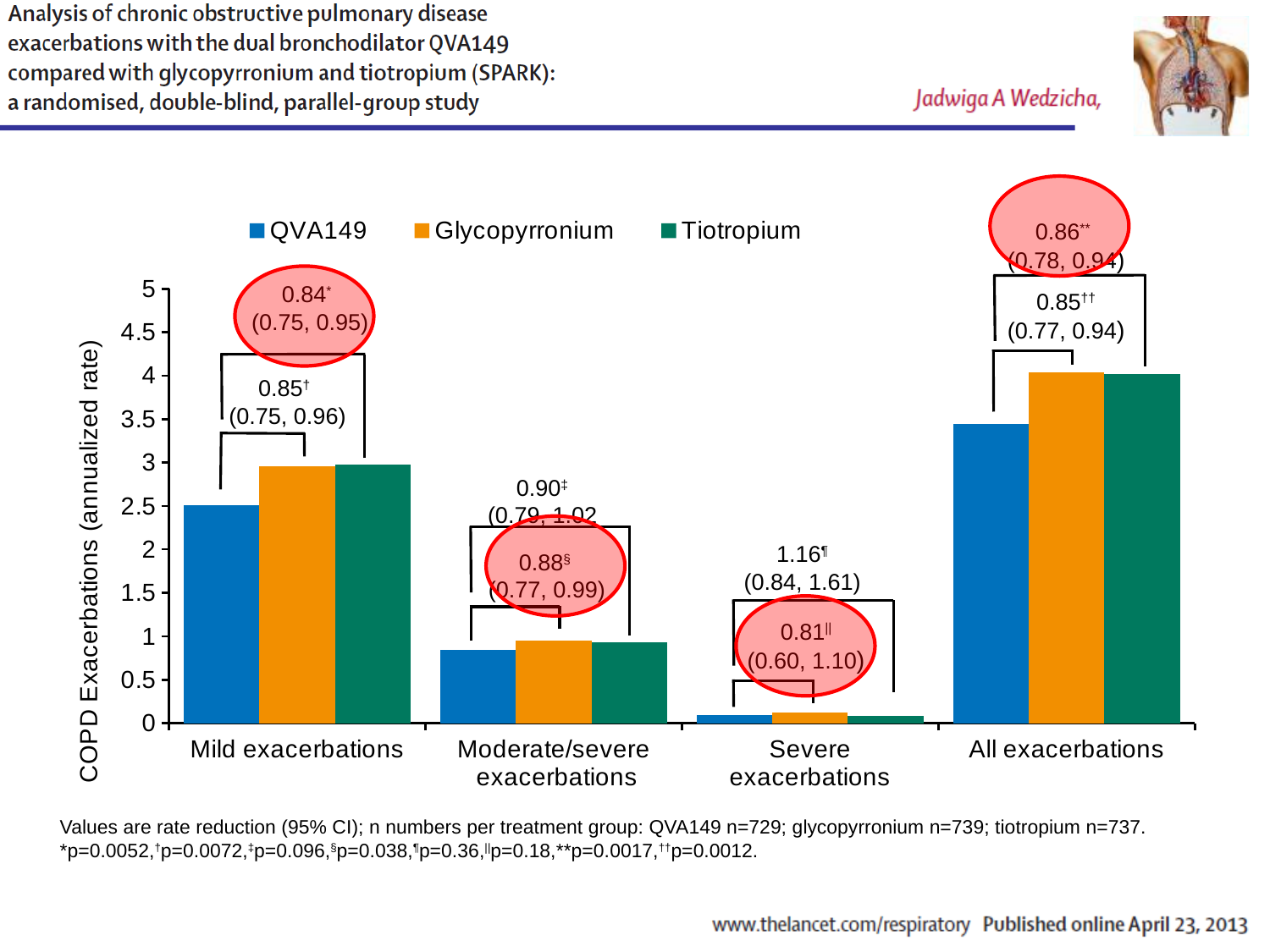
For Mild exacerbations, which is larger: the QVA149 bar or the Glycopyrronium bar? Glycopyrronium What rate reduction and 95% CI is annotated in the circled label above the Mild exacerbations bars? 0.84 (0.75, 0.95) What is the label on the y axis of the chart? COPD Exacerbations (annualized rate) How many exacerbation categories are shown on the x axis? 4 What kind of chart is shown on the slide? bar chart Is the Tiotropium value for Moderate/severe exacerbations greater or less than 1? less Is the QVA149 value for Mild exacerbations greater or less than 3? less Which category has the lowest Glycopyrronium bar? Severe exacerbations For All exacerbations, which is larger: the QVA149 bar or the Tiotropium bar? Tiotropium How many series does the legend list? 3 Which category has the highest QVA149 bar? All exacerbations Is the Glycopyrronium value for All exacerbations greater or less than 3.5? greater